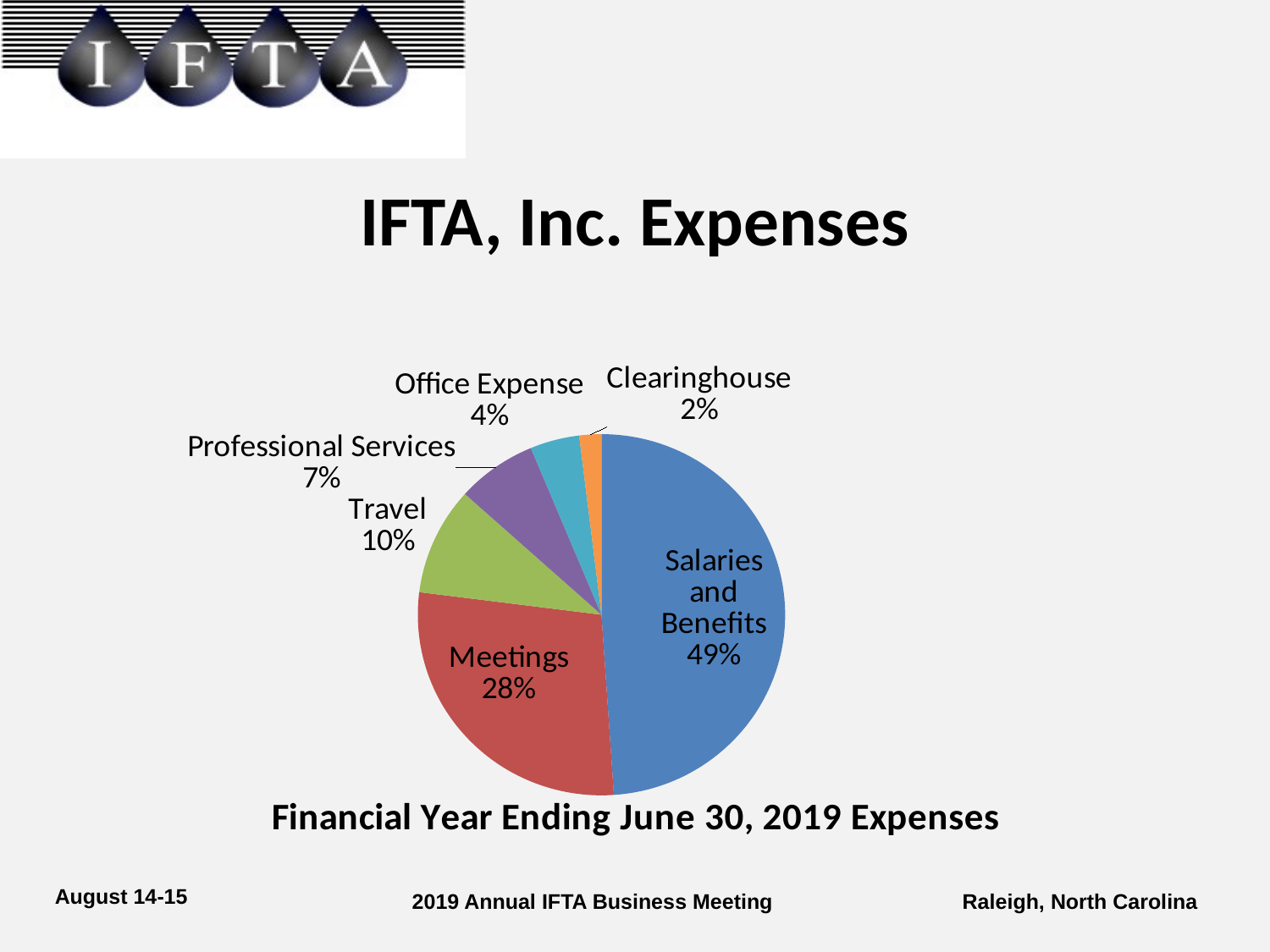
How many percentage points larger is the Meetings share than the Travel share? 18 What kind of chart is shown on the slide? Pie chart What share of expenses is Office Expense? 4% What share of expenses is Travel? 10% What share of expenses is Clearinghouse? 2% How many expense categories are shown in the pie chart? 6 Which expense category has the smallest share? Clearinghouse Which is larger, the share for Professional Services or the share for Office Expense? Professional Services Which expense category has the largest share? Salaries and Benefits